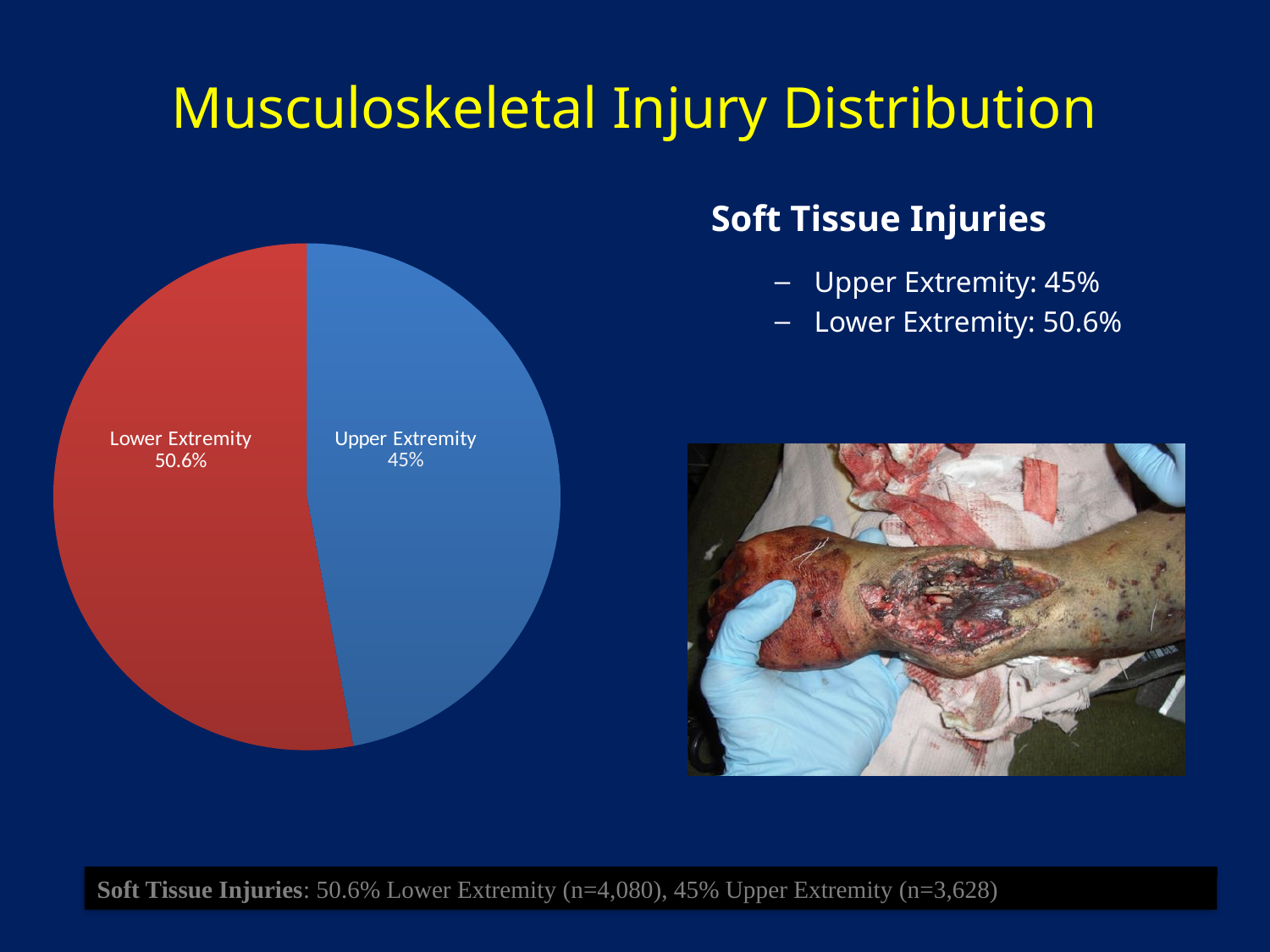
What colour is the Lower Extremity slice in the pie chart? red How many slices does the pie chart have? 2 Which slice of the pie chart is the largest? Lower Extremity What share of the pie does the Upper Extremity slice represent? 45% What colour is the Upper Extremity slice in the pie chart? blue Which slice of the pie chart is the smallest? Upper Extremity What is the difference between the Lower Extremity and Upper Extremity values in the pie chart? 5.6% Which is larger in the pie chart, Lower Extremity or Upper Extremity? Lower Extremity What is the value for Upper Extremity in the pie chart? 45% What kind of chart is shown on the slide? pie chart What is the value for Lower Extremity in the pie chart? 50.6%